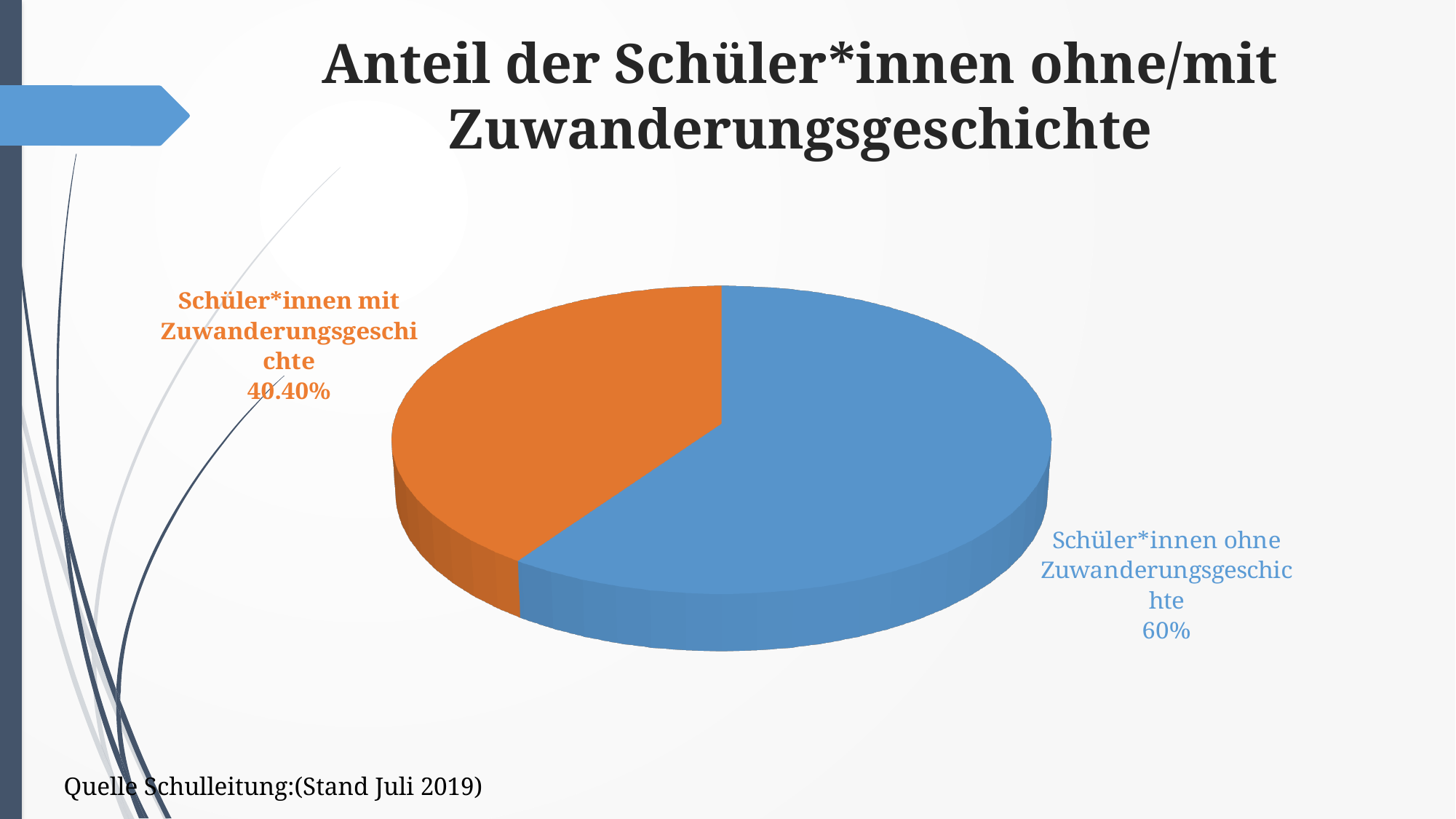
What colour is the slice for Schüler*innen mit Zuwanderungsgeschichte? Orange What kind of chart is shown on the slide? Pie chart Which category has the largest slice of the pie? Schüler*innen ohne Zuwanderungsgeschichte Which slice is larger: Schüler*innen mit Zuwanderungsgeschichte or Schüler*innen ohne Zuwanderungsgeschichte? Schüler*innen ohne Zuwanderungsgeschichte Which category has the smallest slice of the pie? Schüler*innen mit Zuwanderungsgeschichte What share of the pie is labelled for Schüler*innen ohne Zuwanderungsgeschichte? 60% What share of the pie is labelled for Schüler*innen mit Zuwanderungsgeschichte? 40.40% What is the title of the chart on the slide? Anteil der Schüler*innen ohne/mit Zuwanderungsgeschichte How many slices does the pie chart have? 2